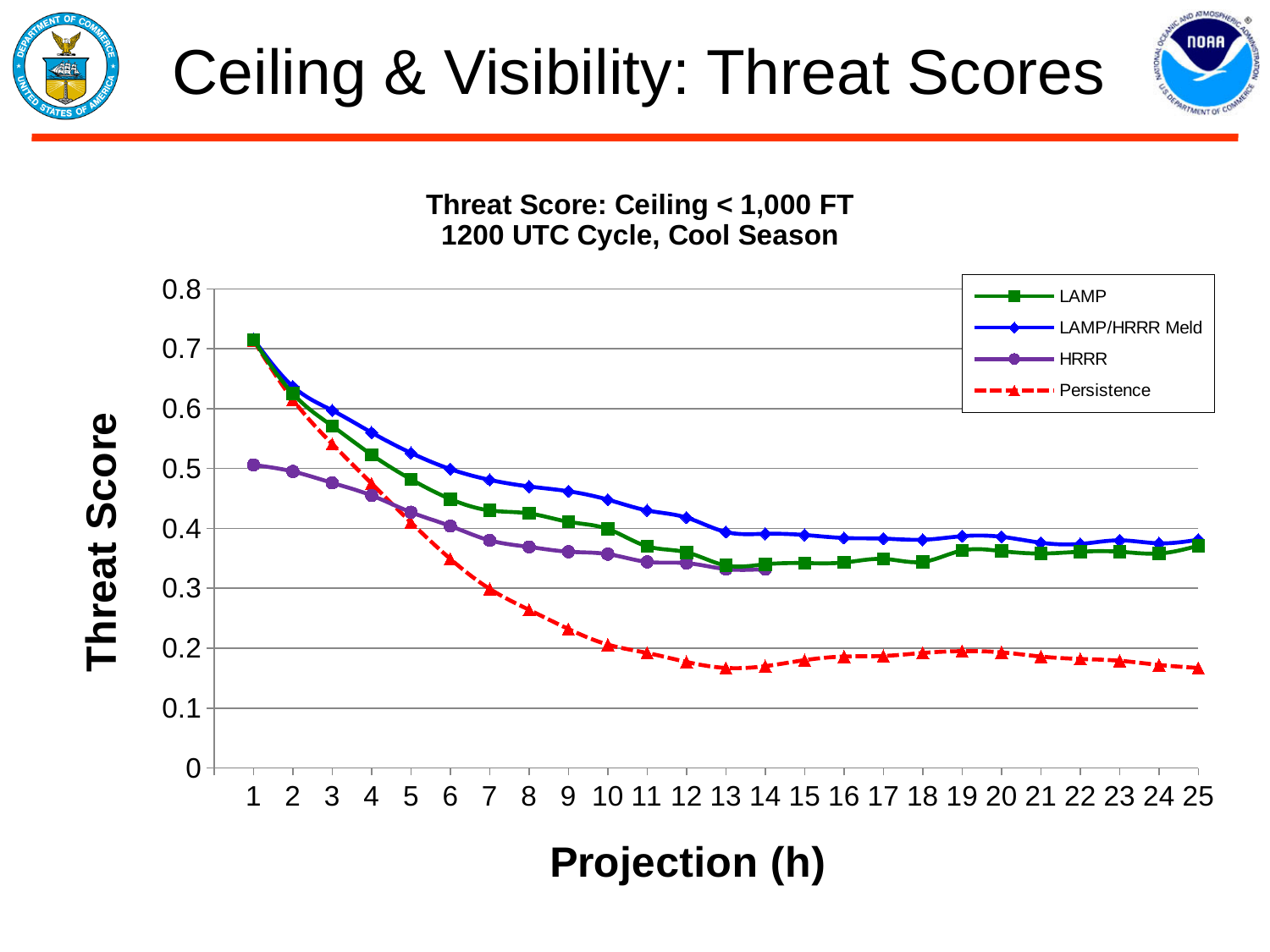
What is the title of the chart? Threat Score: Ceiling < 1,000 FT 1200 UTC Cycle, Cool Season How many projection hours are plotted along the x axis? 25 Which series is drawn with a dashed line? Persistence At projection hour 25, which is larger: LAMP/HRRR Meld or Persistence? LAMP/HRRR Meld Is the Persistence value at projection hour 13 greater or less than 0.2? less Which series has the lowest threat score at projection hour 20? Persistence Which series has the highest threat score at projection hour 10? LAMP/HRRR Meld Does the LAMP threat score rise or fall as the projection hour increases from 1 to 13? Fall How many series does the legend list? 4 Is the LAMP value at projection hour 6 greater or less than 0.4? greater What kind of chart is shown on the slide? Line chart Is the HRRR value at projection hour 1 greater or less than 0.4? greater